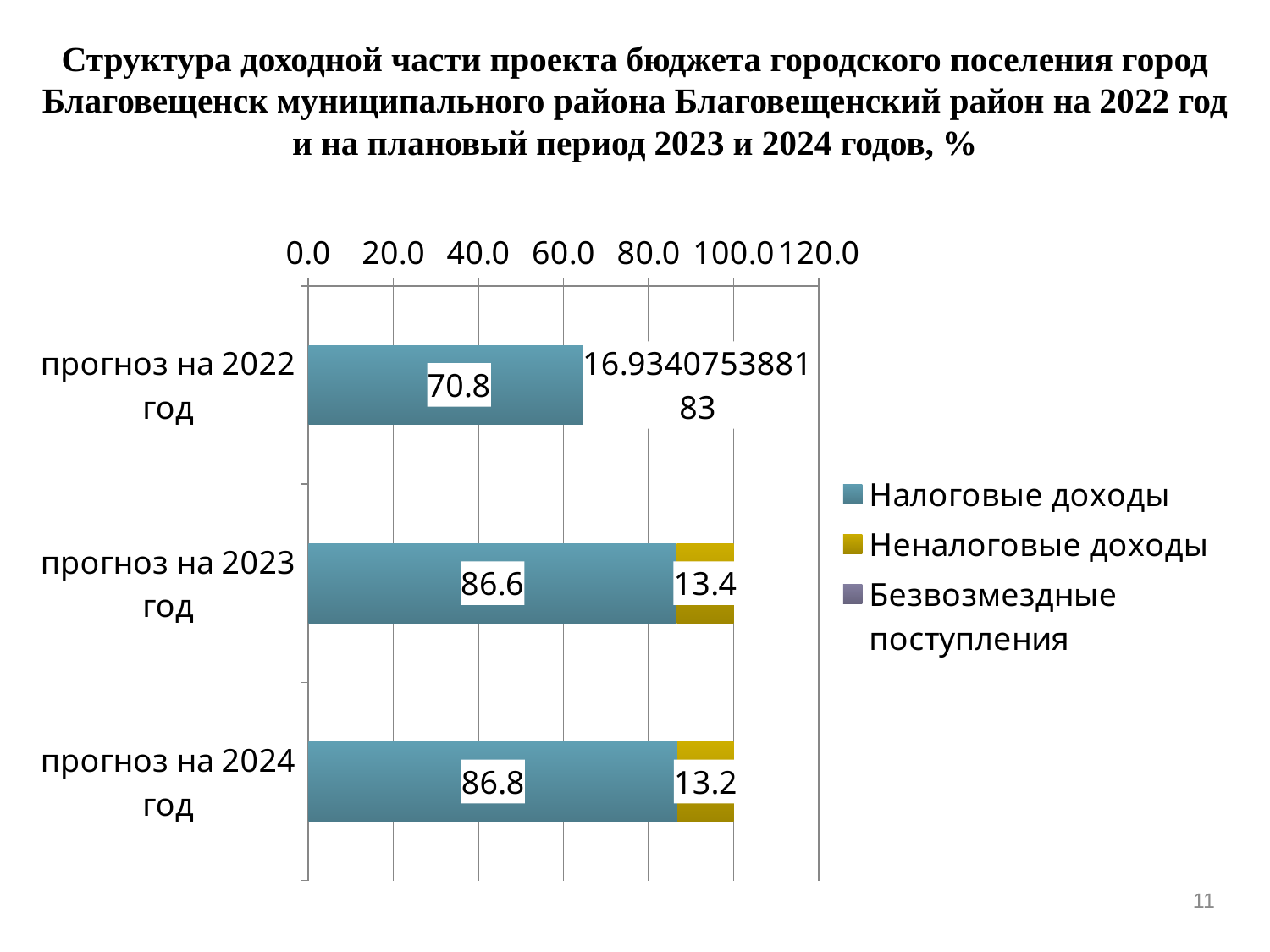
Which is larger: Неналоговые доходы for прогноз на 2023 год or for прогноз на 2024 год? прогноз на 2023 год What is the value of Налоговые доходы for прогноз на 2022 год? 70.8 Is the value of Налоговые доходы for прогноз на 2022 год greater or less than 80.0? less What kind of chart is shown on the slide? Stacked horizontal bar chart Which forecast year has the lowest value for Налоговые доходы? прогноз на 2022 год What is the total of the labelled segments in the bar for прогноз на 2024 год? 100.0 What is the value of Налоговые доходы for прогноз на 2023 год? 86.6 How many forecast years (categories) are shown on the chart? 3 What is the difference between Налоговые доходы for прогноз на 2024 год and прогноз на 2022 год? 16.0 What is the value of Неналоговые доходы for прогноз на 2024 год? 13.2 For прогноз на 2023 год, what is the difference between Налоговые доходы and Неналоговые доходы? 73.2 How many series does the legend list? 3